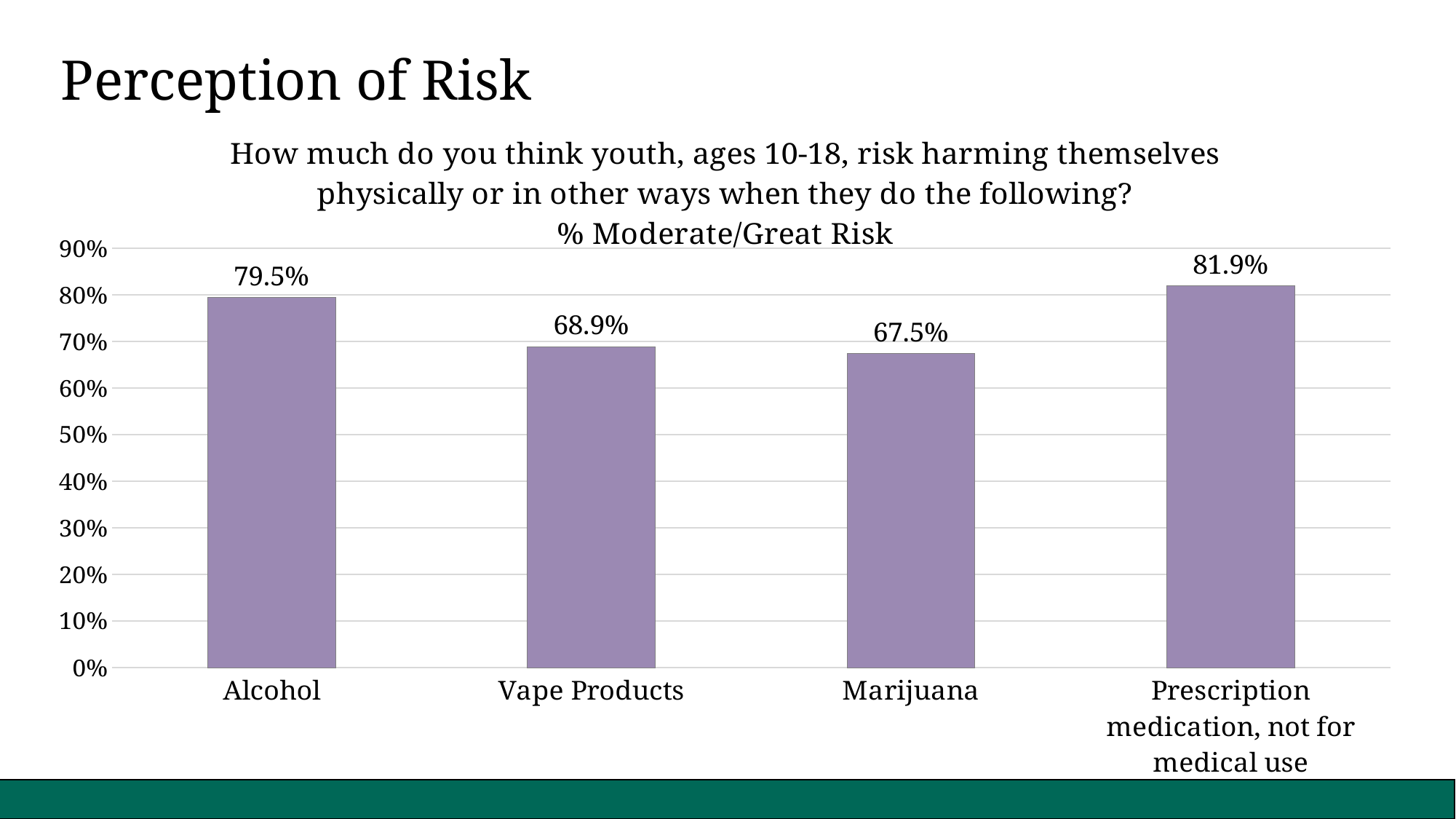
How many categories are shown on the chart? 4 Which category has the lowest value? Marijuana What is the difference between the values for Vape Products and Marijuana? 1.4% Which is larger, the value for Alcohol or the value for Vape Products? Alcohol What is the difference between the values for Prescription medication, not for medical use and Alcohol? 2.4% What is the value for Prescription medication, not for medical use? 81.9% What is the title of the slide? Perception of Risk What is the value for Vape Products? 68.9% What is the value for Marijuana? 67.5% What is the value for Alcohol? 79.5% What kind of chart is shown on the slide? Bar chart Which category has the highest value? Prescription medication, not for medical use